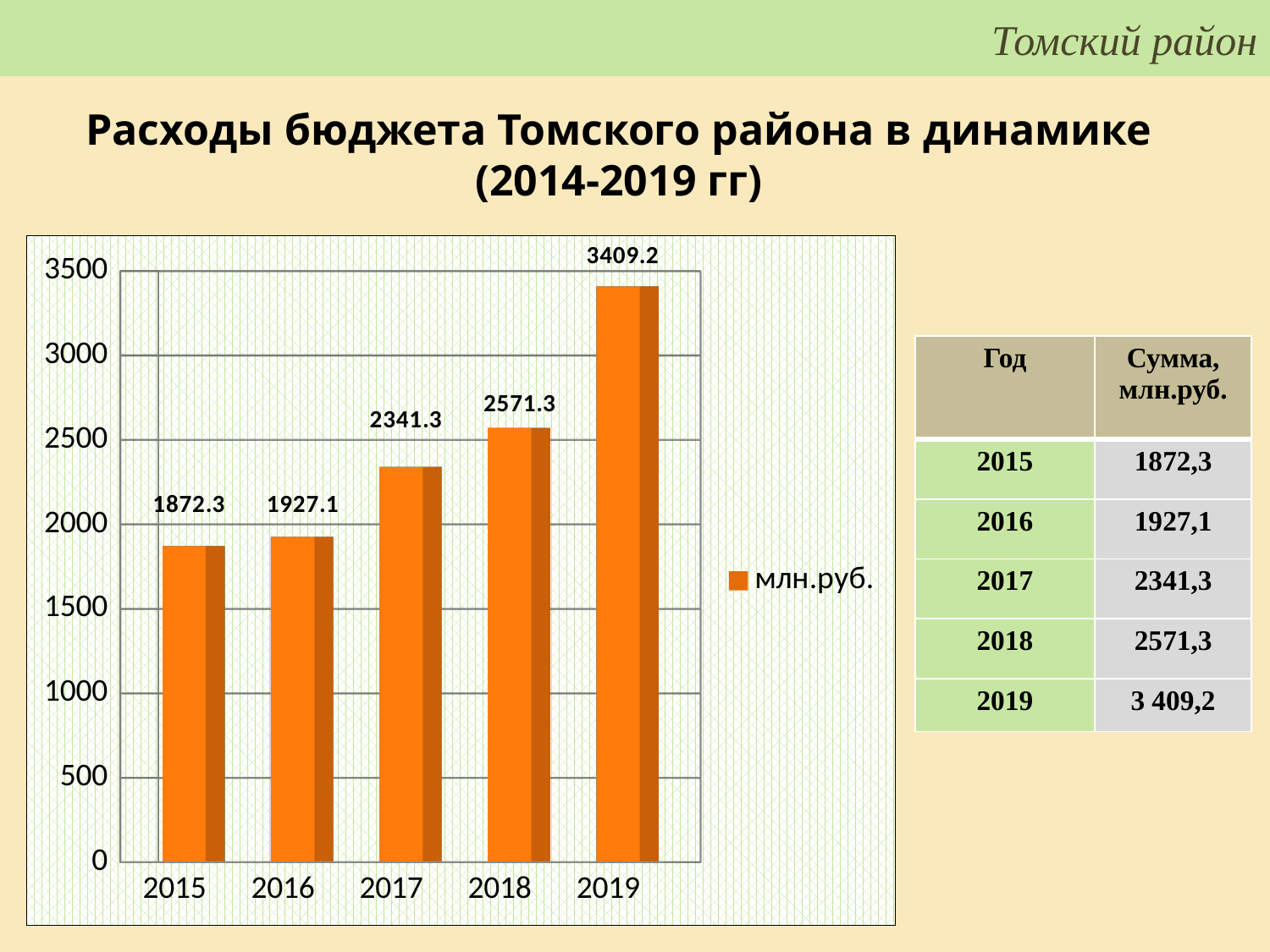
Which year has the highest value in the bar chart? 2019 Is the value for 2018 in the bar chart greater or less than 2500? greater What is the value for 2019 in the bar chart? 3409.2 What is the value for 2017 in the bar chart? 2341.3 What kind of chart is shown on the slide? bar chart Which year has the lowest value in the bar chart? 2015 Do the values in the bar chart rise or fall from 2015 to 2019? rise What is the value for 2015 in the bar chart? 1872.3 What is the difference between the values for 2016 and 2015 in the bar chart? 54.8 What is the difference between the values for 2019 and 2018 in the bar chart? 837.9 Which is larger in the bar chart, the value for 2017 or the value for 2018? 2018 How many years are shown on the x axis of the bar chart? 5